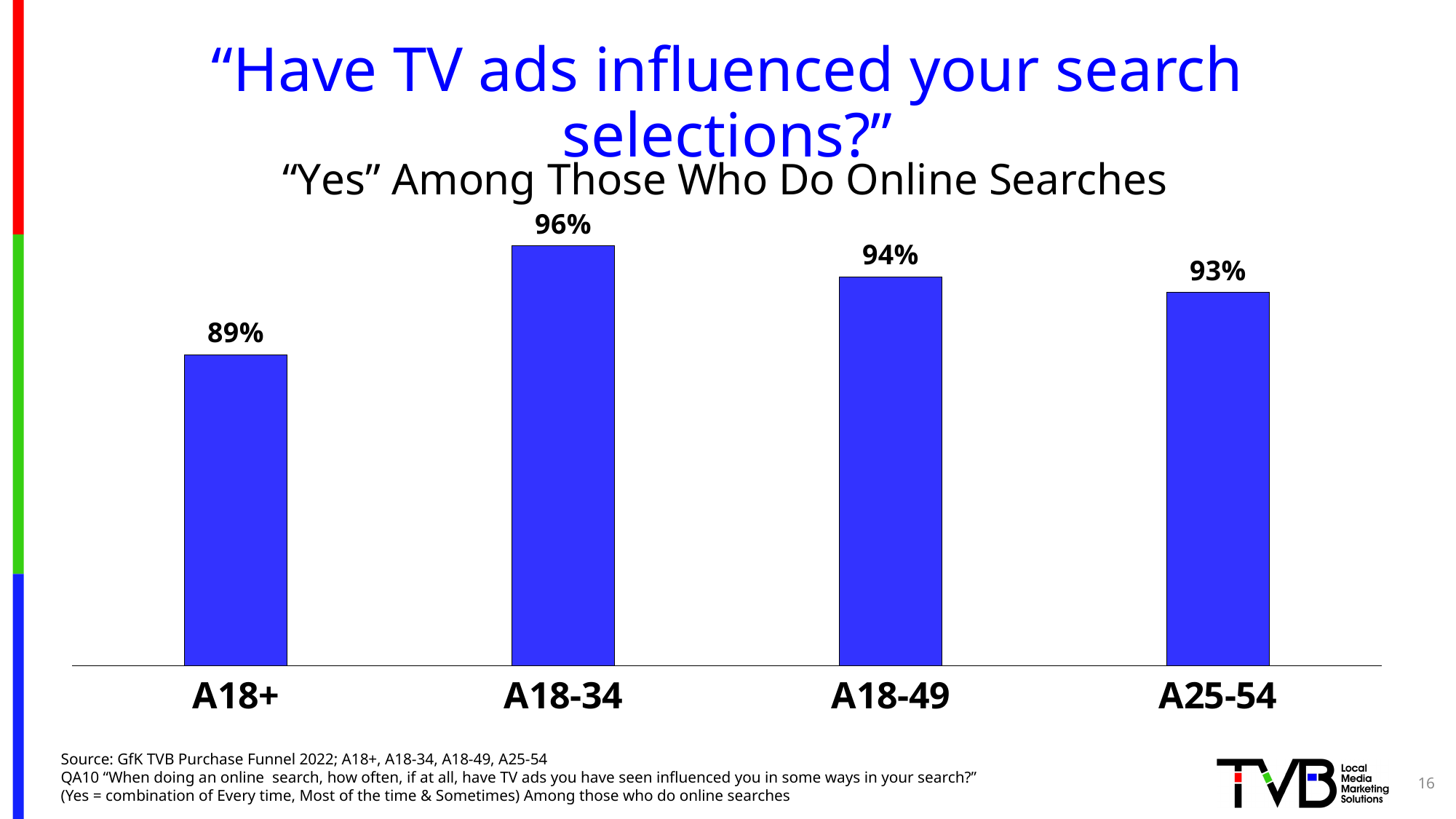
What kind of chart is shown on the slide? Bar chart What percentage of A18+ said TV ads influenced their search selections? 89% Which is larger, the value for A18-49 or the value for A18+? A18-49 Which age group has the highest percentage? A18-34 What is the value shown for A18-34? 96% What is the value shown for A25-54? 93% What is the subtitle shown above the chart? "Yes" Among Those Who Do Online Searches How many age groups are shown in the chart? 4 Which age group has the lowest percentage? A18+ What is the difference between the A18-49 value and the A25-54 value? 1% What is the value shown for A18-49? 94% What is the difference between the A18-34 value and the A18+ value? 7%